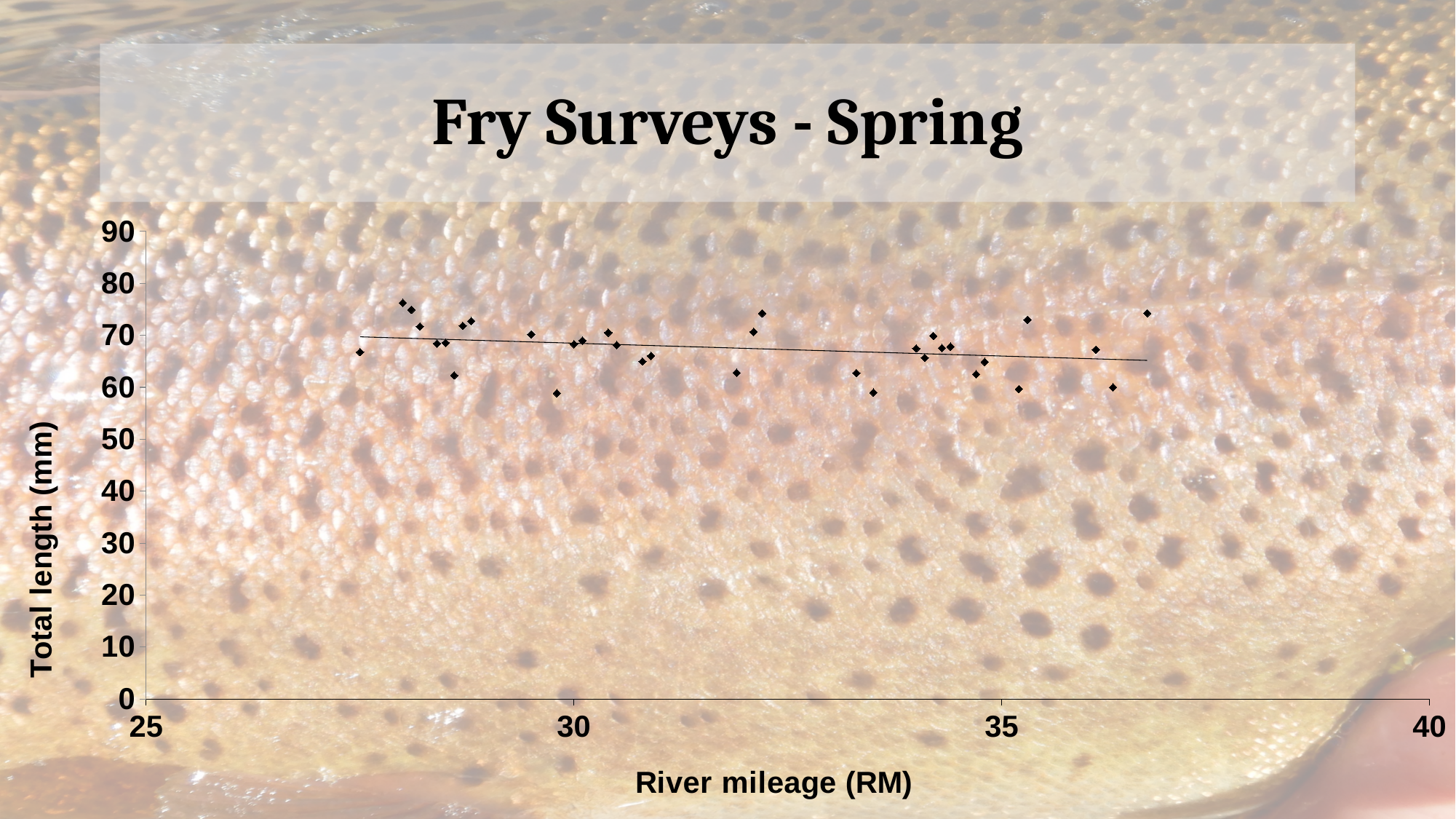
Is the trend line value at river mile 30 greater or less than 60 mm? greater Are any data points plotted at a river mileage greater than 37? No What is the label of the x axis? River mileage (RM) What is the maximum value shown on the y axis? 90 What is the title of the chart? Fry Surveys - Spring Is the lowest plotted total length greater or less than 50 mm? greater What kind of chart is shown on the slide? Scatter plot Does the fitted trend line rise or fall as river mileage increases? Fall